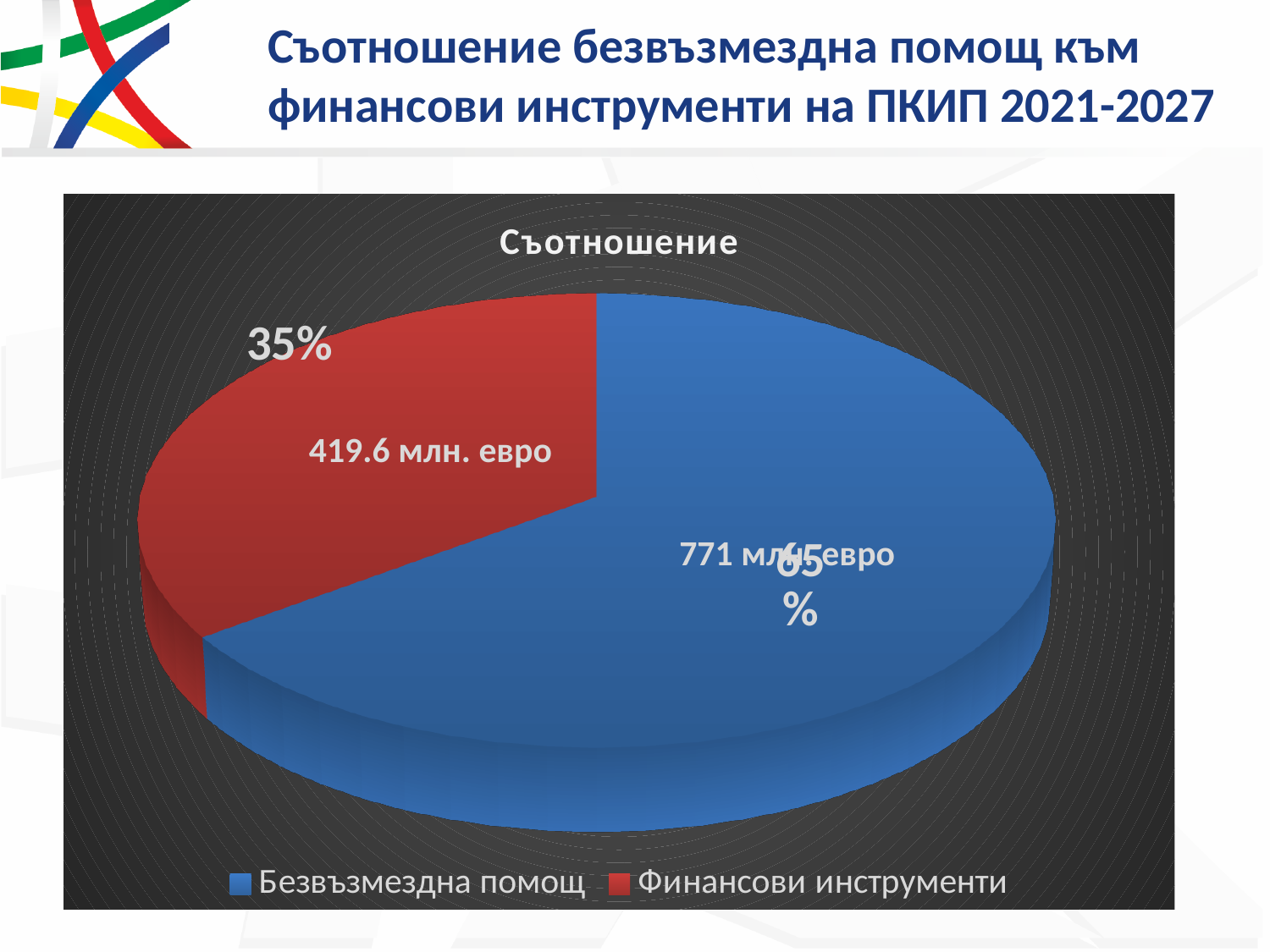
Which slice is the largest? Безвъзмездна помощ How many slices does the pie chart have? 2 What is the value shown for Финансови инструменти? 419.6 млн. евро What is the value shown for Безвъзмездна помощ? 771 млн. евро What colour is the slice for Финансови инструменти? red How many entries does the legend list? 2 Which is larger, Безвъзмездна помощ or Финансови инструменти? Безвъзмездна помощ What is the title of the chart? Съотношение Which slice is the smallest? Финансови инструменти What share of the pie does Финансови инструменти represent? 35% What kind of chart is shown on the slide? pie chart What share of the pie does Безвъзмездна помощ represent? 65%